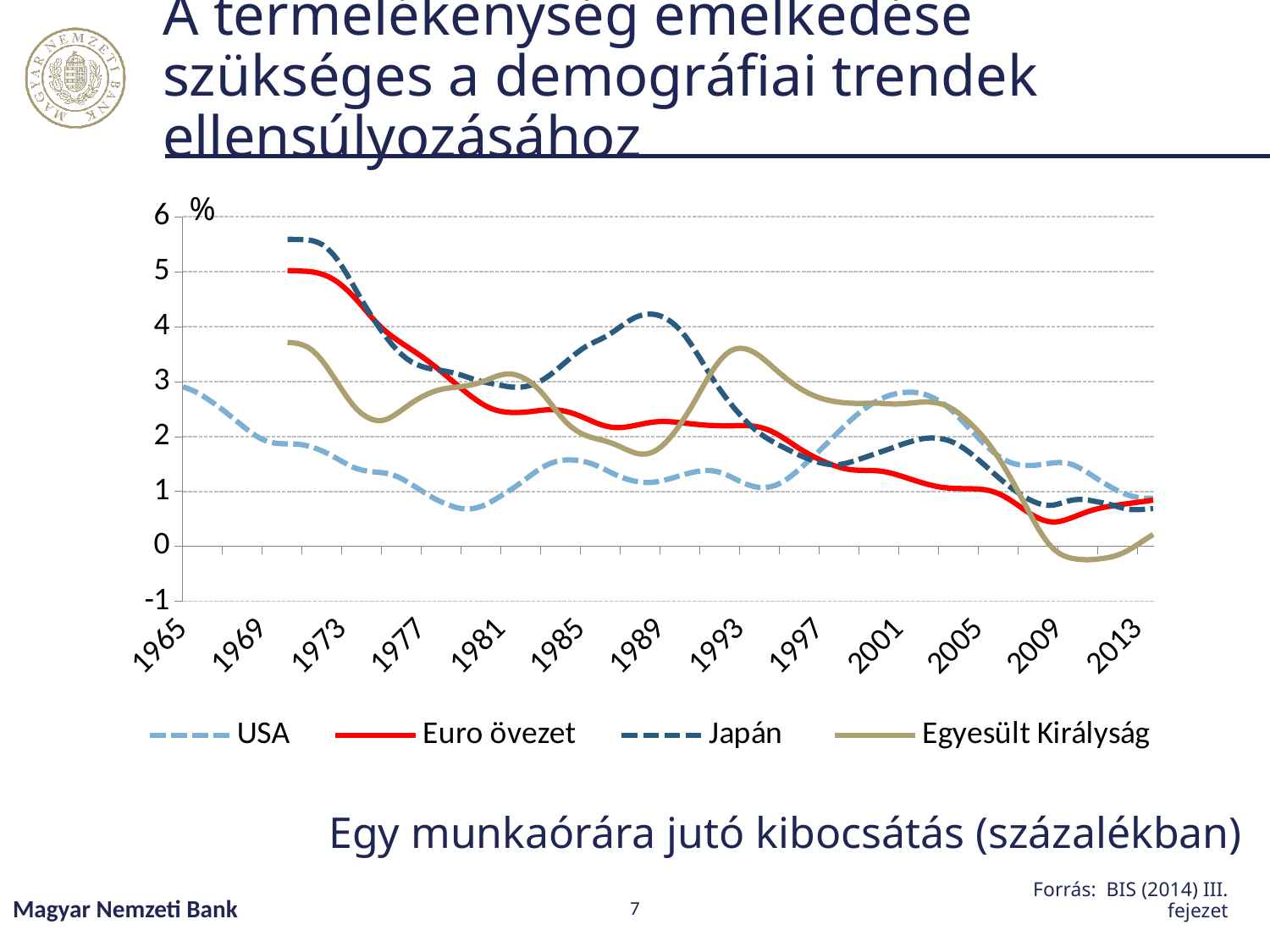
In 2001, which is larger: the value for USA or the value for Euro övezet? USA Which series is the only one that drops below 0 on the chart? Egyesült Királyság Is the value for Euro övezet in 1971 greater or less than 4? greater Is the value for Japán in 1997 greater or less than 3? less Which series has the highest value at the start of its line in 1971? Japán Does the Euro övezet line overall rise or fall from 1971 to 2013? fall In 1989, which is larger: the value for Japán or the value for Euro övezet? Japán How many series does the legend list? 4 What kind of chart is shown on the slide? line chart Which series are listed in the legend? USA, Euro övezet, Japán, Egyesült Királyság What is the caption below the chart? Egy munkaórára jutó kibocsátás (százalékban)